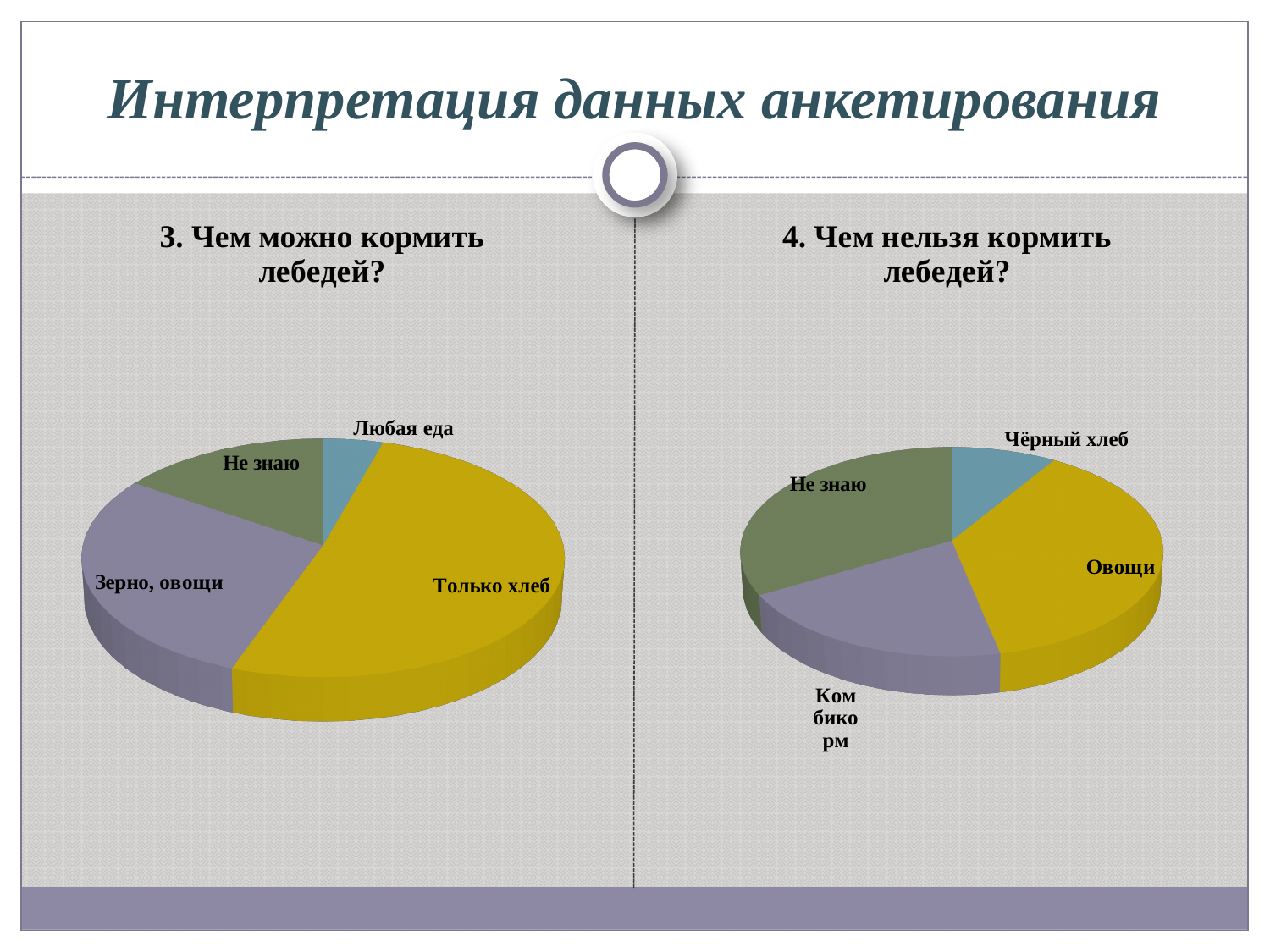
What kind of chart is used for "3. Чем можно кормить лебедей?"? pie chart In the chart "3. Чем можно кормить лебедей?", which answer has the largest slice? Только хлеб What kind of chart is used for "4. Чем нельзя кормить лебедей?"? pie chart In the chart "4. Чем нельзя кормить лебедей?", which slice is larger: "Комбикорм" or "Чёрный хлеб"? Комбикорм In the chart "4. Чем нельзя кормить лебедей?", how many slices does the pie have? 4 What is the title of the slide containing the two pie charts? Интерпретация данных анкетирования In the chart "3. Чем можно кормить лебедей?", which slice is larger: "Зерно, овощи" or "Не знаю"? Зерно, овощи In the chart "3. Чем можно кормить лебедей?", which answer has the smallest slice? Любая еда In the chart "4. Чем нельзя кормить лебедей?", which answer has the largest slice? Овощи In the chart "4. Чем нельзя кормить лебедей?", which answer has the smallest slice? Чёрный хлеб In the chart "3. Чем можно кормить лебедей?", how many slices does the pie have? 4 In the chart "3. Чем можно кормить лебедей?", what colour is the "Только хлеб" slice? yellow